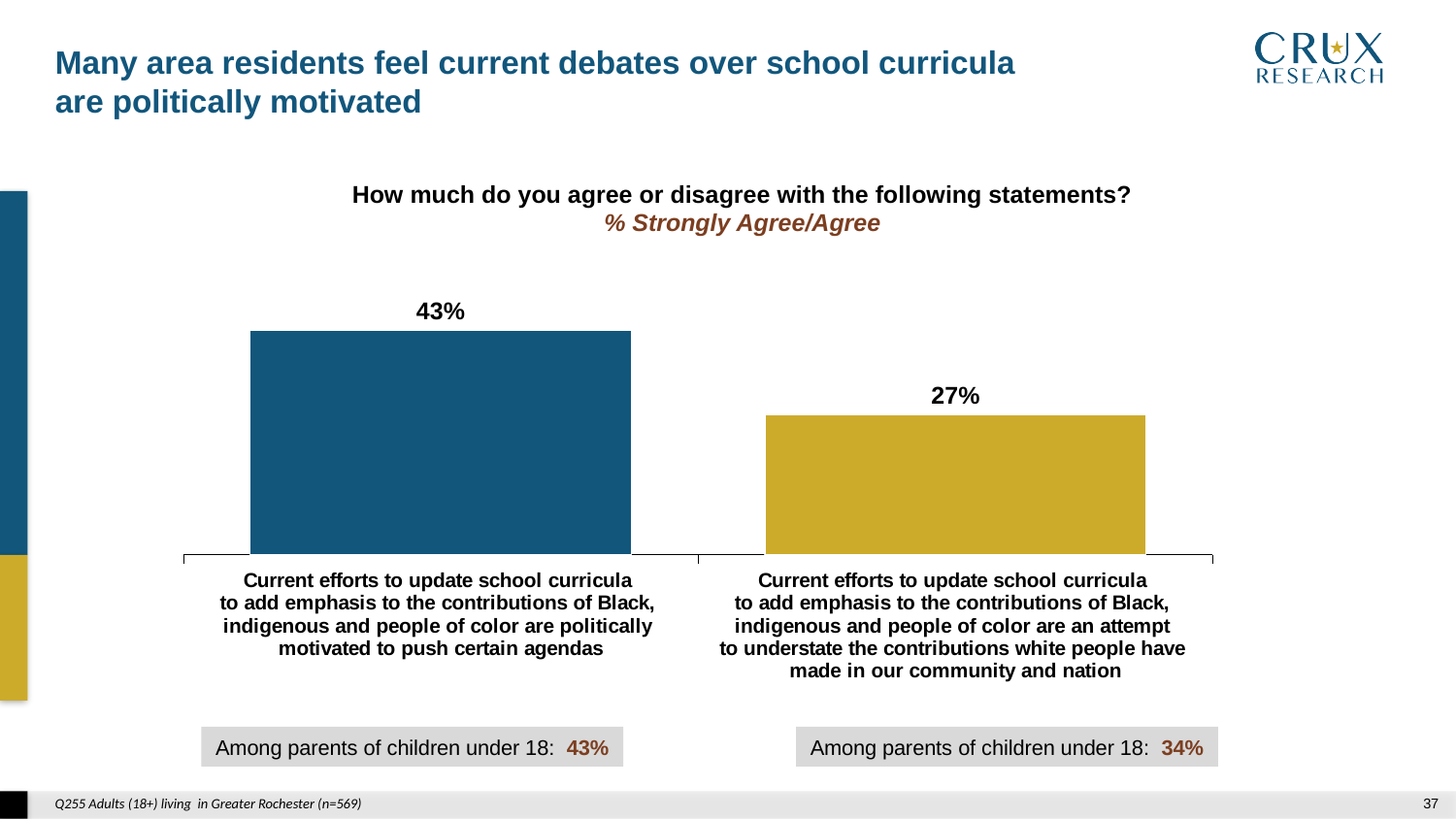
What measure does the chart subtitle say the bars represent? % Strongly Agree/Agree Is the value for the 'politically motivated to push certain agendas' statement larger or smaller than the value for the 'attempt to understate the contributions white people have made' statement? larger Among parents of children under 18, what percentage agree that current efforts to update school curricula are politically motivated to push certain agendas? 43% Which statement has the higher share of respondents who strongly agree or agree? Current efforts to update school curricula to add emphasis to the contributions of Black, indigenous and people of color are politically motivated to push certain agendas What colour is the bar for the 'politically motivated to push certain agendas' statement? blue What percentage of respondents strongly agree or agree that current efforts to update school curricula are an attempt to understate the contributions white people have made? 27% What is the difference in percentage points between the two bars on the chart? 16 percentage points Among parents of children under 18, what percentage agree that current efforts to update school curricula are an attempt to understate the contributions white people have made? 34% What type of chart is shown on the slide? bar chart How many bars are shown on the chart? 2 What percentage of respondents strongly agree or agree that current efforts to update school curricula are politically motivated to push certain agendas? 43%